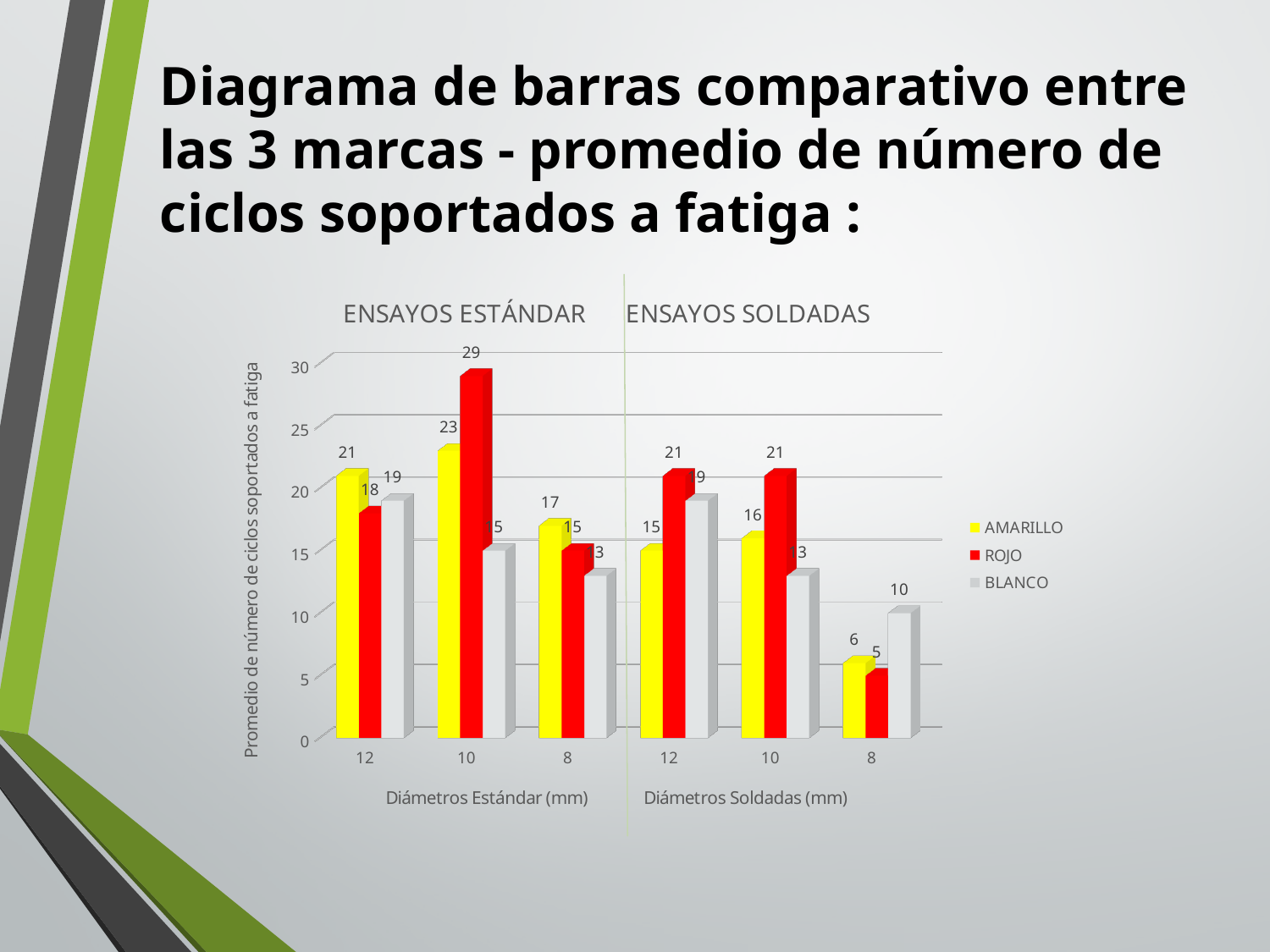
How many series does the legend list? 3 Which is larger at 12 mm in the Ensayos Soldadas group, ROJO or AMARILLO? ROJO What is the value for AMARILLO at 8 mm in the Ensayos Soldadas group? 6 What is the label of the vertical axis? Promedio de número de ciclos soportados a fatiga What is the difference between ROJO and AMARILLO at 10 mm in the Ensayos Estándar group? 6 What is the value for ROJO at 10 mm in the Ensayos Estándar group? 29 What is the value for AMARILLO at 12 mm in the Ensayos Estándar group? 21 Which bar has the highest value in the whole chart? ROJO at 10 mm (Ensayos Estándar), 29 How does the AMARILLO value change across the Ensayos Soldadas diameters from 12 mm to 8 mm? It rises slightly from 15 to 16, then falls to 6 What kind of chart is shown on the slide? Bar chart What is the value for BLANCO at 8 mm in the Ensayos Soldadas group? 10 Which bar has the lowest value in the whole chart? ROJO at 8 mm (Ensayos Soldadas), 5